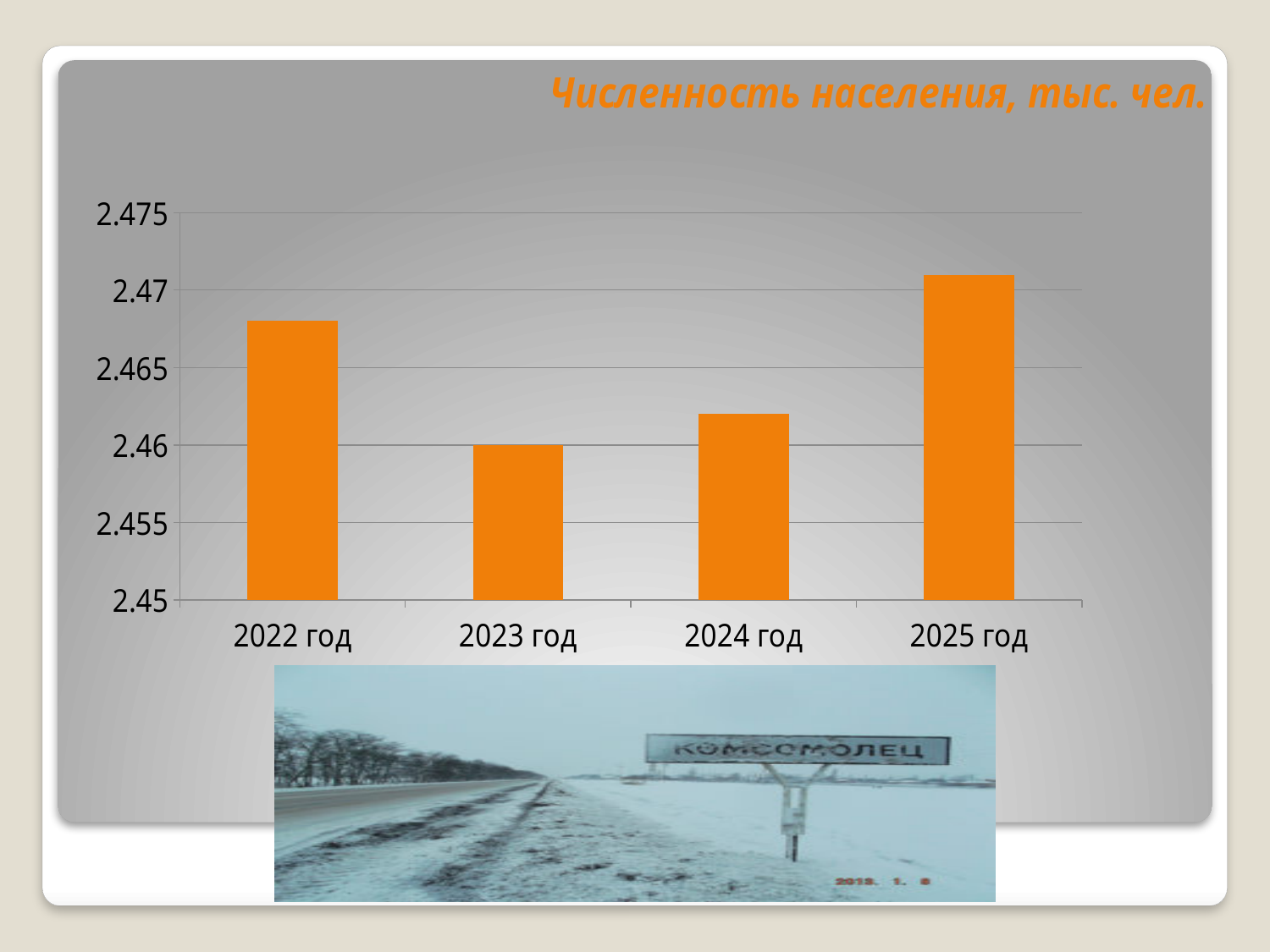
How many years (categories) are shown on the x axis of the chart? 4 Which year has the highest population value in the chart? 2025 год Is the value for 2025 год greater or less than 2.465? greater Is the value for 2024 год greater or less than 2.465? less Which year has the lowest population value in the chart? 2023 год Is the value for 2022 год greater or less than 2.465? greater What kind of chart is shown on the slide? bar chart What is the value for 2023 год in the chart? 2.46 Which is larger, the value for 2022 год or the value for 2024 год? 2022 год What is the title of the chart? Численность населения, тыс. чел. Do the values rise or fall from 2023 год to 2025 год? rise